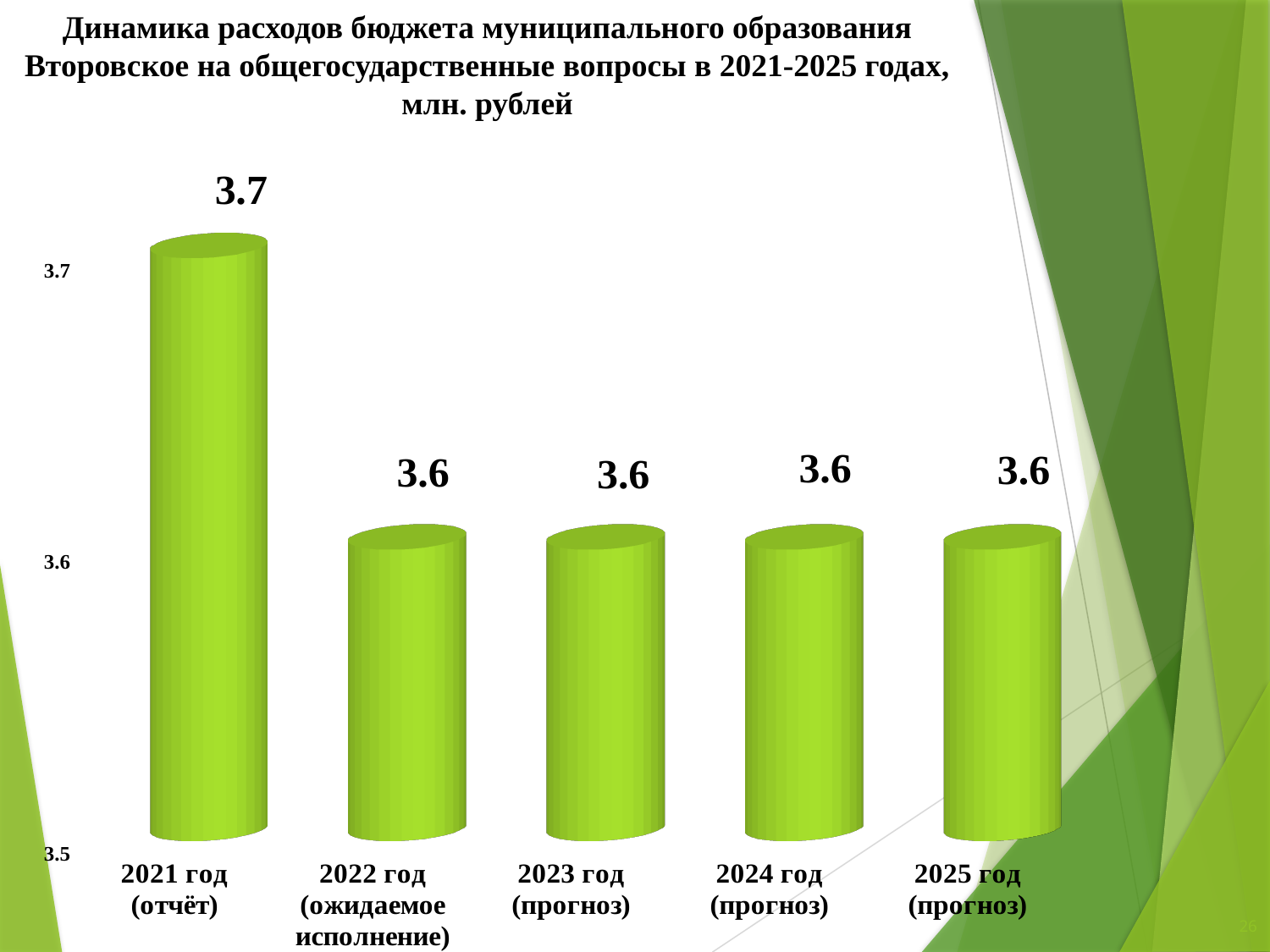
Do the values rise or fall from 2021 to 2022? fall What is the lowest value shown on the vertical axis? 3.5 What is the value for 2025 год (прогноз)? 3.6 What is the value for 2023 год (прогноз)? 3.6 What is the difference between the values for 2021 год (отчёт) and 2022 год (ожидаемое исполнение)? 0.1 How many categories are shown on the x axis? 5 What is the value for 2021 год (отчёт)? 3.7 What kind of chart is shown on the slide? bar chart What unit of measurement is stated in the chart title? млн. рублей Which year has the highest value? 2021 год (отчёт) Which is larger, the value for 2021 год (отчёт) or the value for 2024 год (прогноз)? 2021 год (отчёт)